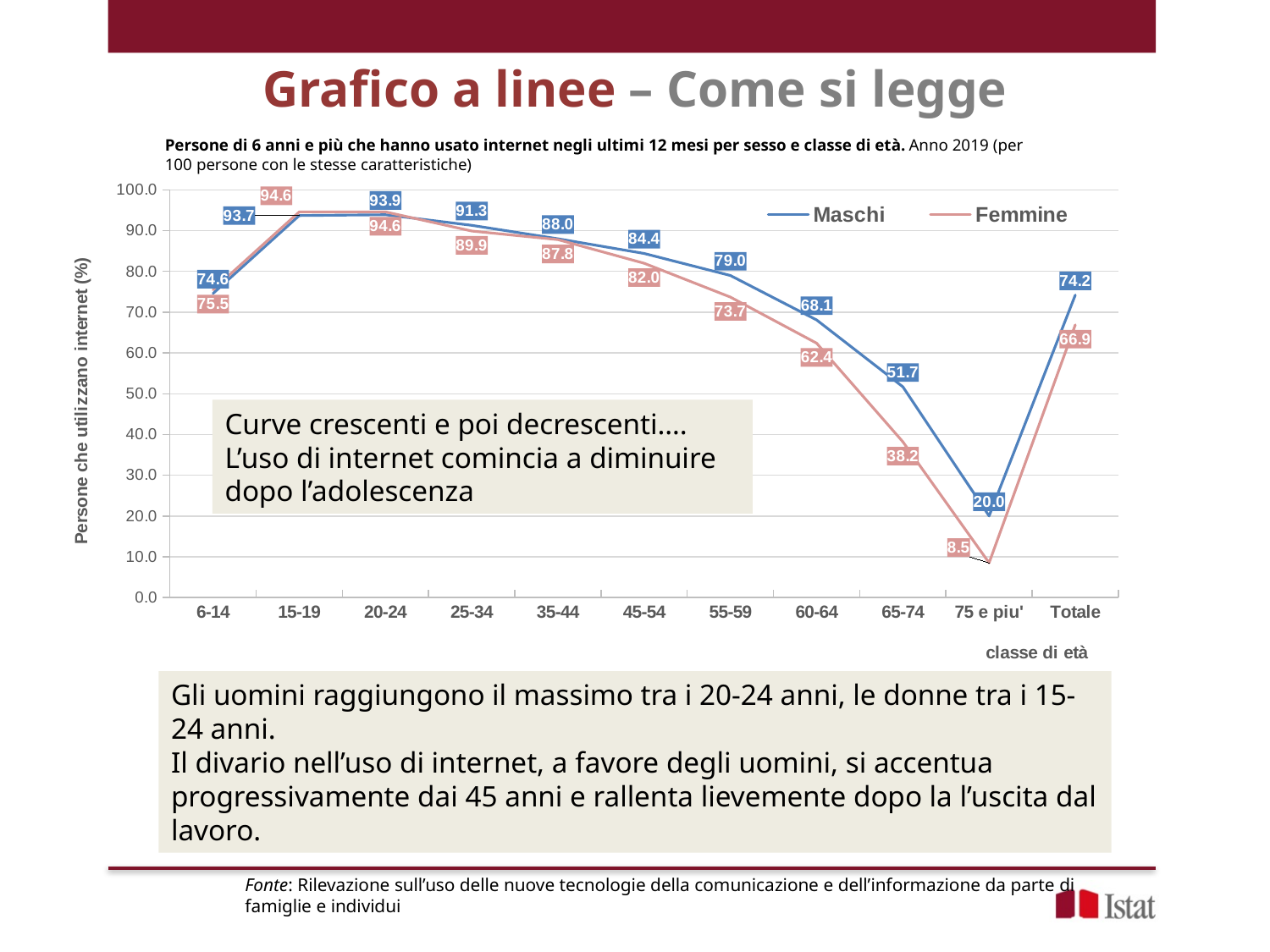
In which age class does the Maschi series reach its highest value? 20-24 How many age-class categories are shown on the x axis, including 'Totale'? 11 What are the two series names listed in the legend? Maschi and Femmine In which age class does the Femmine series reach its lowest value? 75 e piu' How many series does the legend list? 2 What is the value for Femmine in the 'Totale' category? 66.9 What is the difference between the Maschi and Femmine values in the 65-74 age class? 13.5 Do the Maschi values rise or fall from the 20-24 age class to the '75 e piu'' age class? fall What kind of chart is shown on the slide? line chart What is the value for Femmine in the '75 e piu'' age class? 8.5 In the 60-64 age class, which series has the larger value, Maschi or Femmine? Maschi What is the value for Maschi in the 65-74 age class? 51.7